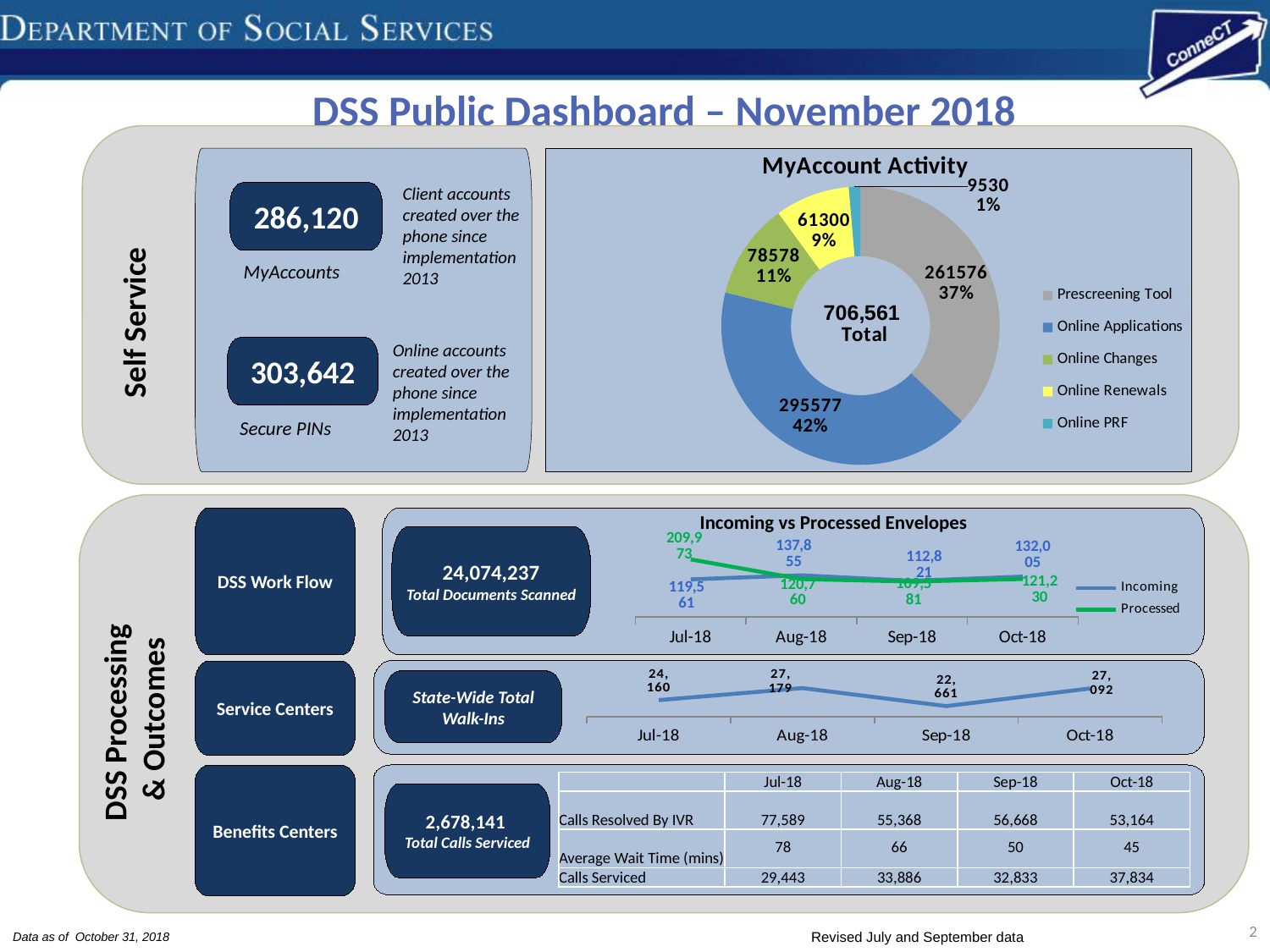
In the State-Wide Total Walk-Ins chart, what is the difference between the Aug-18 and Sep-18 values? 4,518 In the MyAccount Activity chart, which category has the smallest share? Online PRF In the MyAccount Activity chart, what is the difference between the Online Applications value and the Prescreening Tool value? 34001 In the MyAccount Activity chart, which category has the largest share? Online Applications In the Incoming vs Processed Envelopes chart, in which month is the Processed value highest? Jul-18 How many series does the legend of the Incoming vs Processed Envelopes chart list? 2 In the MyAccount Activity chart, what value is shown for Online Applications? 295577 How many categories does the legend of the MyAccount Activity chart list? 5 In the Incoming vs Processed Envelopes chart, which is larger in Jul-18, Incoming or Processed? Processed In the MyAccount Activity chart, what percentage share does the Prescreening Tool have? 37% In the State-Wide Total Walk-Ins chart, what is the value for Sep-18? 22,661 What total is printed in the centre of the MyAccount Activity chart? 706,561